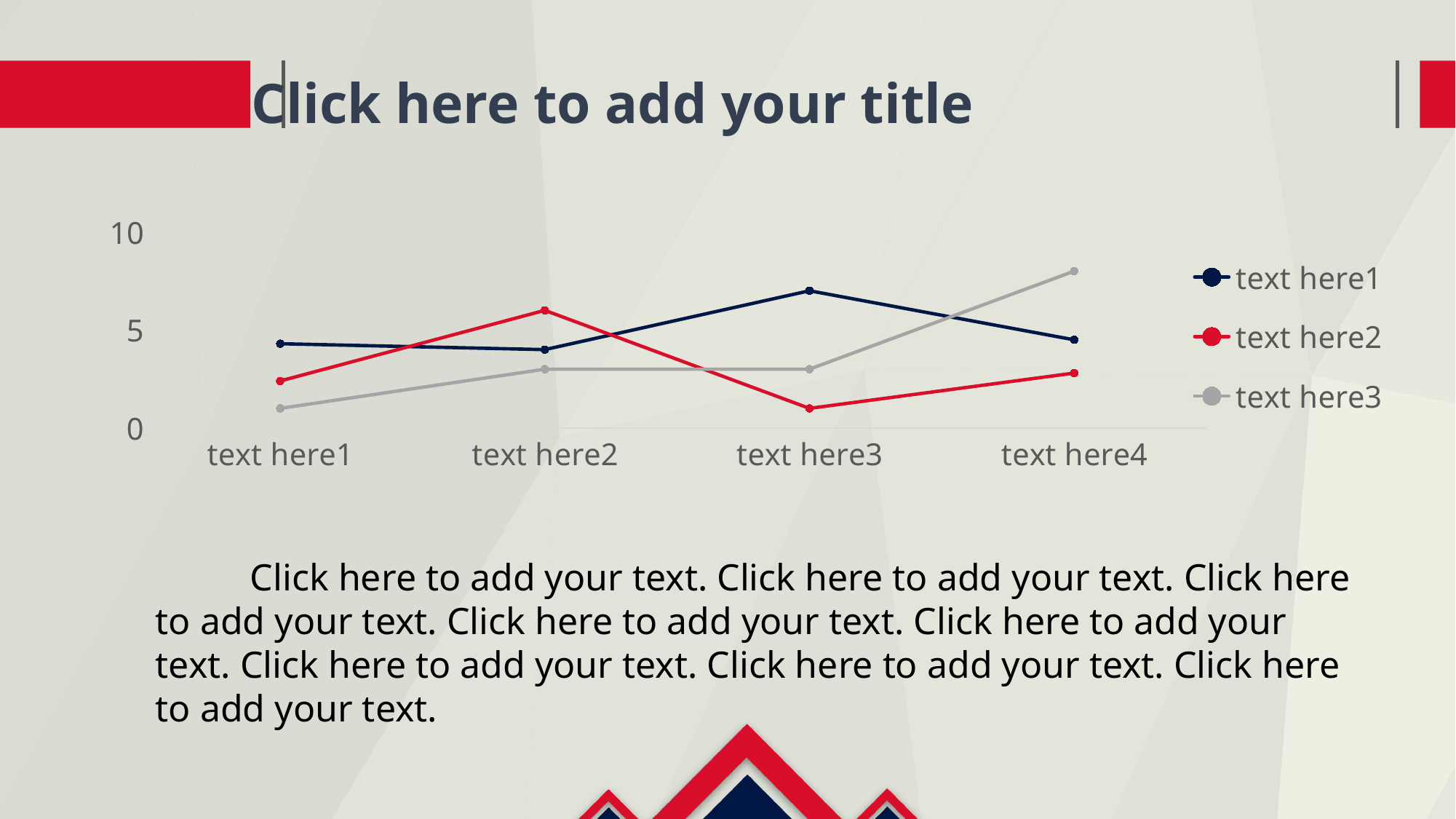
How many categories are shown on the x axis? 4 At text here3, which series has the larger value: text here1 or text here2? text here1 At which category does the text here1 series reach its highest value? text here3 What kind of chart is shown on the slide? line chart Does the text here3 series rise or fall overall from text here1 to text here4? rise Is the value of the text here1 series at text here3 greater or less than 5? greater How many series does the legend list? 3 Is the value of the text here2 series at text here3 greater or less than 5? less At which category does the text here2 series reach its lowest value? text here3 Is the value of the text here3 series at text here4 greater or less than 5? greater At which category does the text here3 series reach its highest value? text here4